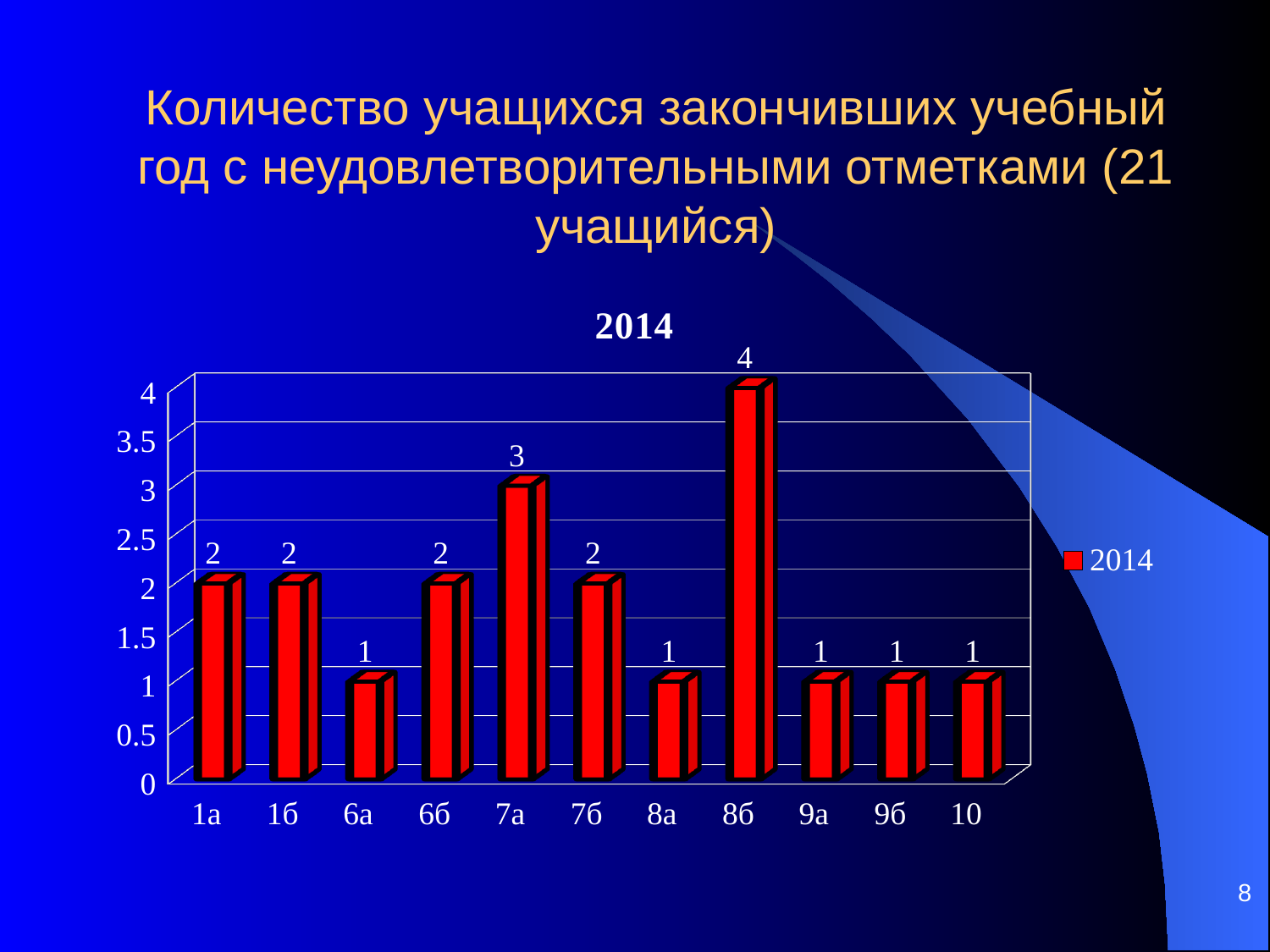
How many series does the legend list? 1 What colour are the bars? red Which class has the highest value? 8б What is the value for class 8б? 4 What is the value for class 6а? 1 How many classes have a value of 1? 5 What is the chart title? 2014 What kind of chart is shown? bar chart What is the difference between the values for 8б and 7а? 1 Which is larger, the value for 1а or the value for 8а? 1а How many classes are shown on the x axis? 11 What is the value for class 7а? 3